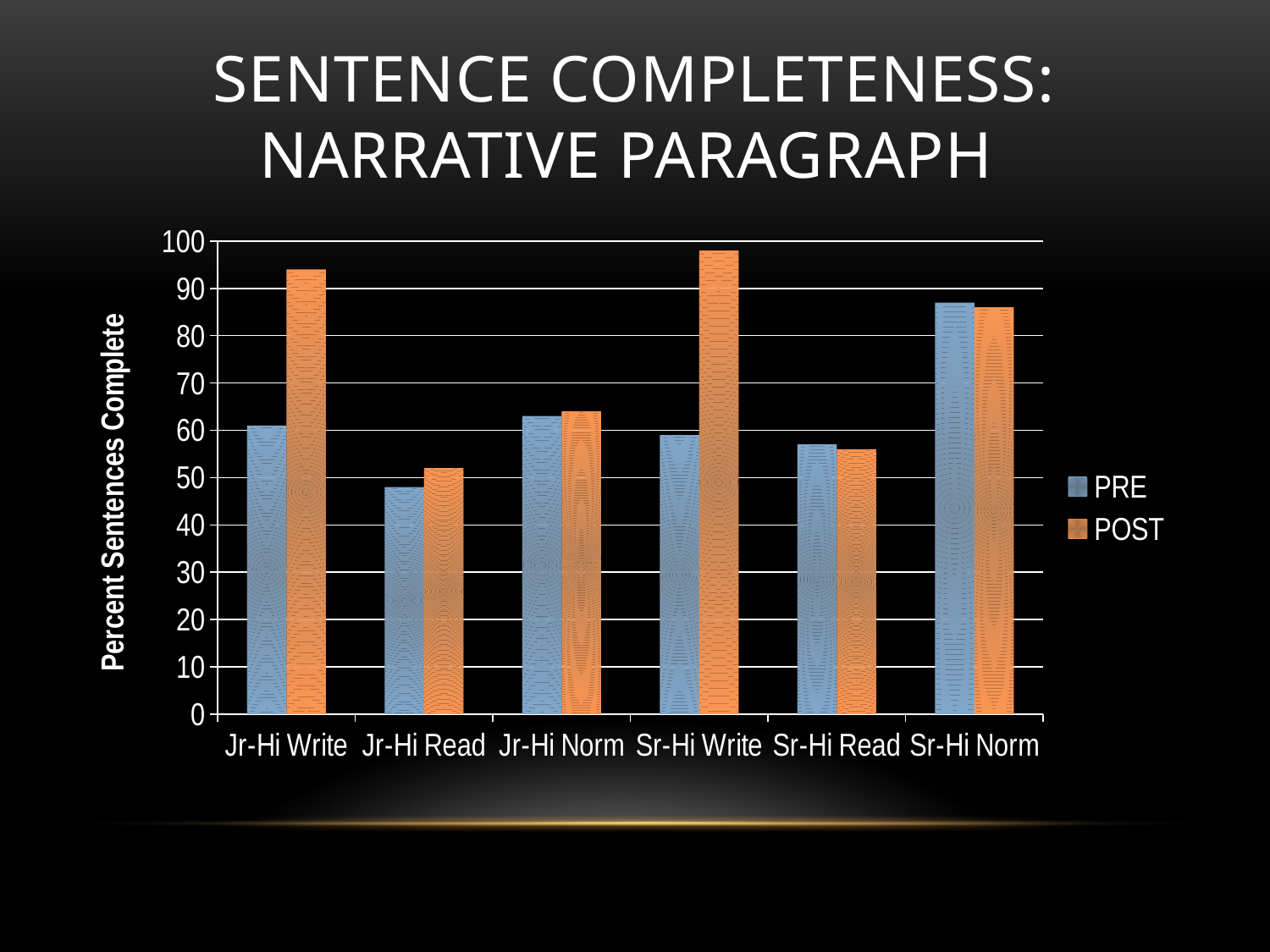
Is the PRE value for Sr-Hi Norm greater or less than 80? greater For Sr-Hi Write, which is larger, the PRE value or the POST value? POST Is the POST value for Jr-Hi Write greater or less than 90? greater How many series does the legend list? 2 What is the label on the vertical axis? Percent Sentences Complete Which is larger, the PRE value for Sr-Hi Norm or the PRE value for Jr-Hi Write? Sr-Hi Norm Which category has the lowest PRE value? Jr-Hi Read Which category has the lowest POST value? Jr-Hi Read What type of chart is shown on the slide? bar chart How many categories are shown on the x axis? 6 Which category has the highest POST value? Sr-Hi Write Is the PRE value for Jr-Hi Read greater or less than 50? less